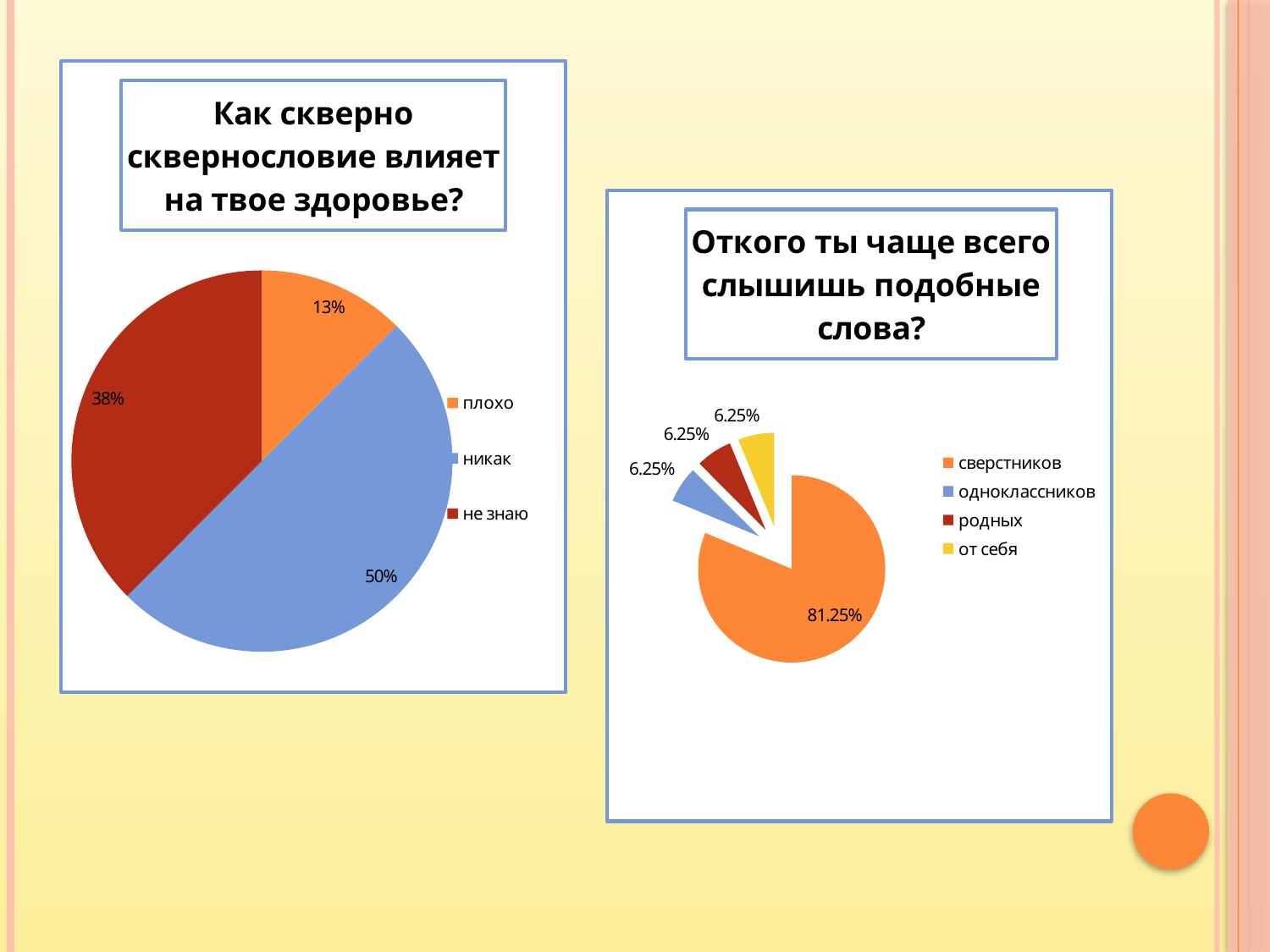
In the left chart titled "Как скверно сквернословие влияет на твое здоровье?", how many categories does the legend list? 3 In the left chart titled "Как скверно сквернословие влияет на твое здоровье?", what is the difference in percentage points between "никак" and "не знаю"? 12 In the left chart titled "Как скверно сквернословие влияет на твое здоровье?", what percentage is shown for "никак"? 50% What type of chart is the right chart titled "Откого ты чаще всего слышишь подобные слова?"? pie chart In the right chart titled "Откого ты чаще всего слышишь подобные слова?", what percentage is shown for "сверстников"? 81.25% In the left chart titled "Как скверно сквернословие влияет на твое здоровье?", which category has the smallest slice? плохо In the left chart titled "Как скверно сквернословие влияет на твое здоровье?", which category has the largest slice? никак In the right chart titled "Откого ты чаще всего слышишь подобные слова?", what percentage is shown for "родных"? 6.25% In the right chart titled "Откого ты чаще всего слышишь подобные слова?", how many categories does the legend list? 4 In the left chart titled "Как скверно сквернословие влияет на твое здоровье?", what percentage is shown for "плохо"? 13% In the left chart titled "Как скверно сквернословие влияет на твое здоровье?", what percentage is shown for "не знаю"? 38% In the right chart titled "Откого ты чаще всего слышишь подобные слова?", which category has the largest slice? сверстников